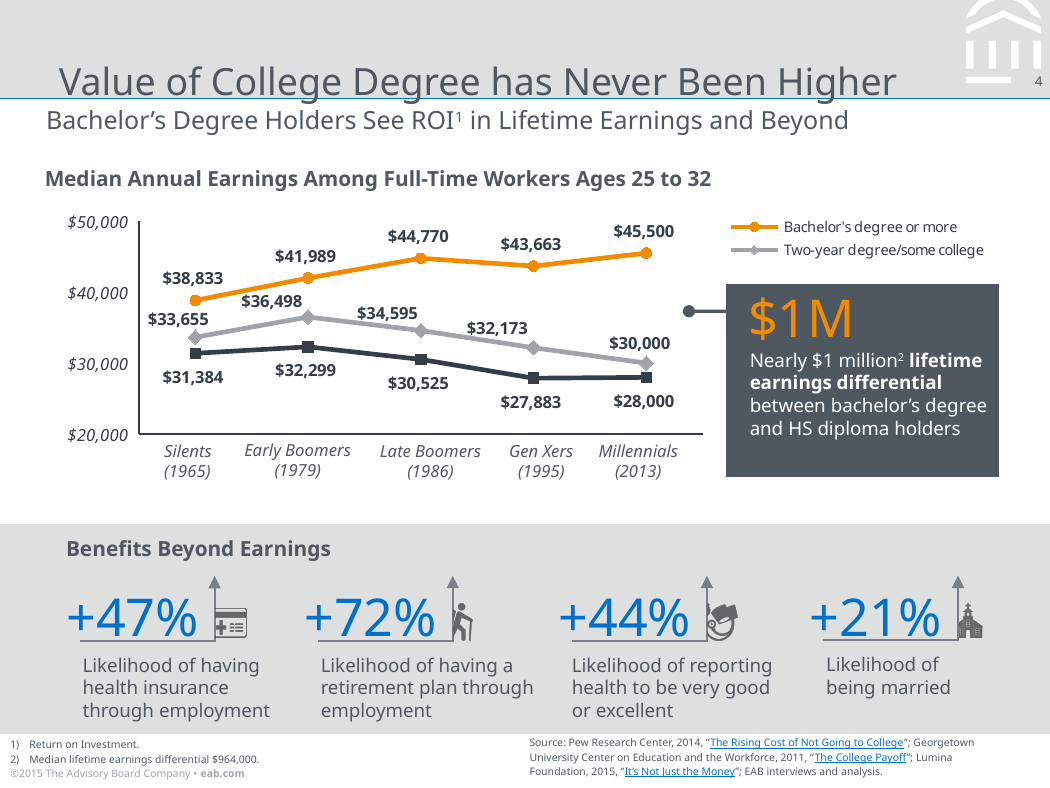
What is the median annual earnings for Bachelor's degree or more among Millennials (2013)? $45,500 How many series does the legend list? 2 What is the median annual earnings for Two-year degree/some college among Silents (1965)? $33,655 How many generation categories are shown on the x axis? 5 Which generation has the highest median annual earnings for Bachelor's degree or more? Millennials (2013) Which is larger: Two-year degree/some college earnings for Early Boomers (1979) or for Gen Xers (1995)? Early Boomers (1979) What is the difference between Bachelor's degree or more and Two-year degree/some college earnings among Late Boomers (1986)? $10,175 What kind of chart is used to show median annual earnings? Line chart What is the median annual earnings for Bachelor's degree or more among Late Boomers (1986)? $44,770 What is the difference between Bachelor's degree or more and Two-year degree/some college earnings among Millennials (2013)? $15,500 Which generation has the lowest median annual earnings for Two-year degree/some college? Millennials (2013) Do Two-year degree/some college earnings rise or fall from Early Boomers (1979) to Millennials (2013)? Fall